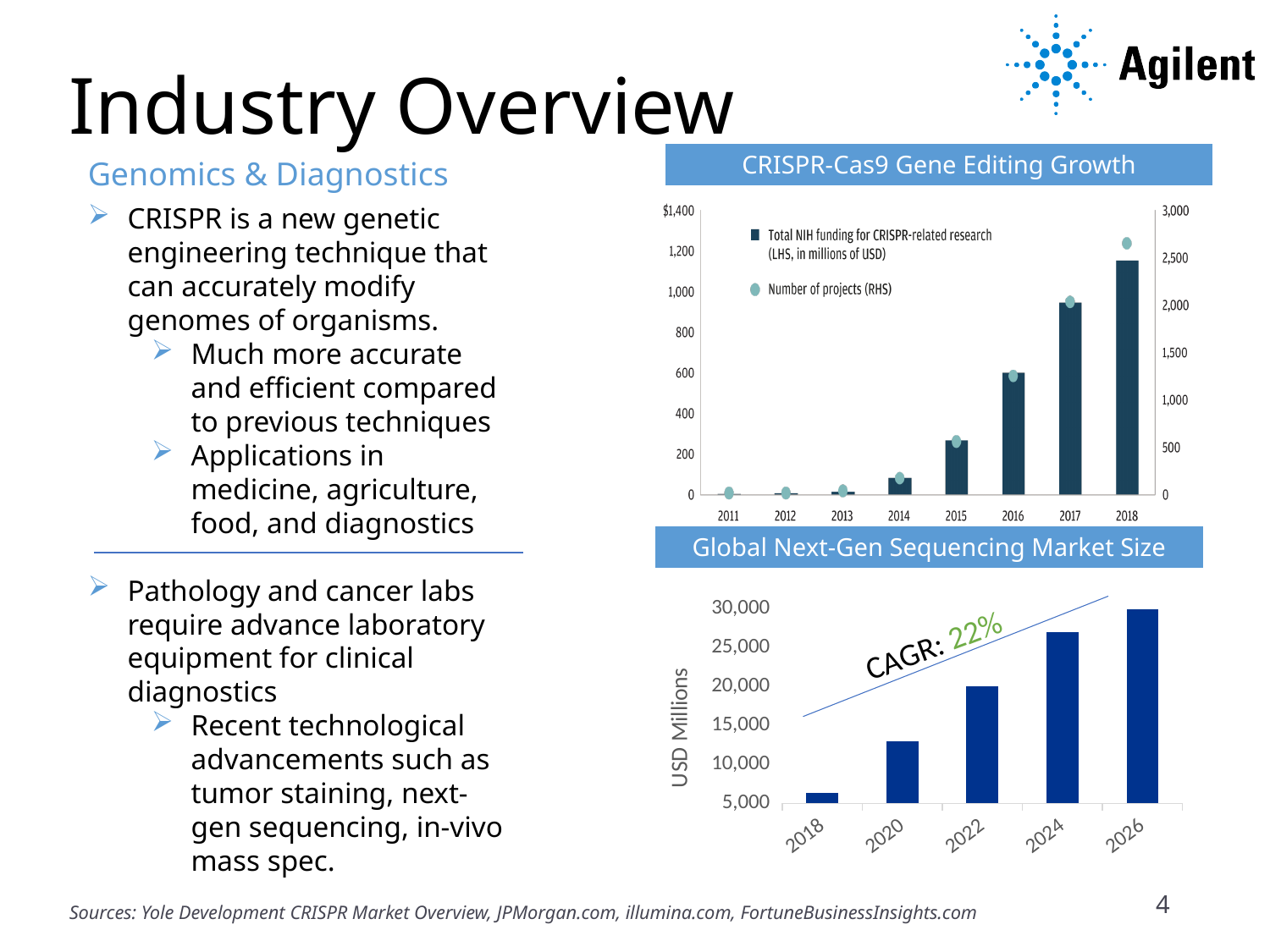
In the CRISPR-Cas9 Gene Editing Growth chart, which year has the tallest bar for total NIH funding? 2018 In the CRISPR-Cas9 Gene Editing Growth chart, is the NIH funding bar for 2018 greater or less than 1,000? greater In the Global Next-Gen Sequencing Market Size chart, which year has the highest value? 2026 In the CRISPR-Cas9 Gene Editing Growth chart, which series is plotted on the right-hand axis according to the legend? Number of projects (RHS) What kind of chart is the Global Next-Gen Sequencing Market Size chart? bar chart In the CRISPR-Cas9 Gene Editing Growth chart, how many years are shown on the x axis? 8 In the Global Next-Gen Sequencing Market Size chart, what CAGR is annotated on the chart? 22% In the Global Next-Gen Sequencing Market Size chart, which year has the lowest value? 2018 In the CRISPR-Cas9 Gene Editing Growth chart, do the NIH funding bars rise or fall from 2011 to 2018? rise In the Global Next-Gen Sequencing Market Size chart, is the value for 2022 greater or less than 15,000? greater In the CRISPR-Cas9 Gene Editing Growth chart, is the NIH funding bar for 2015 greater or less than 400? less In the CRISPR-Cas9 Gene Editing Growth chart, how many series does the legend list? 2